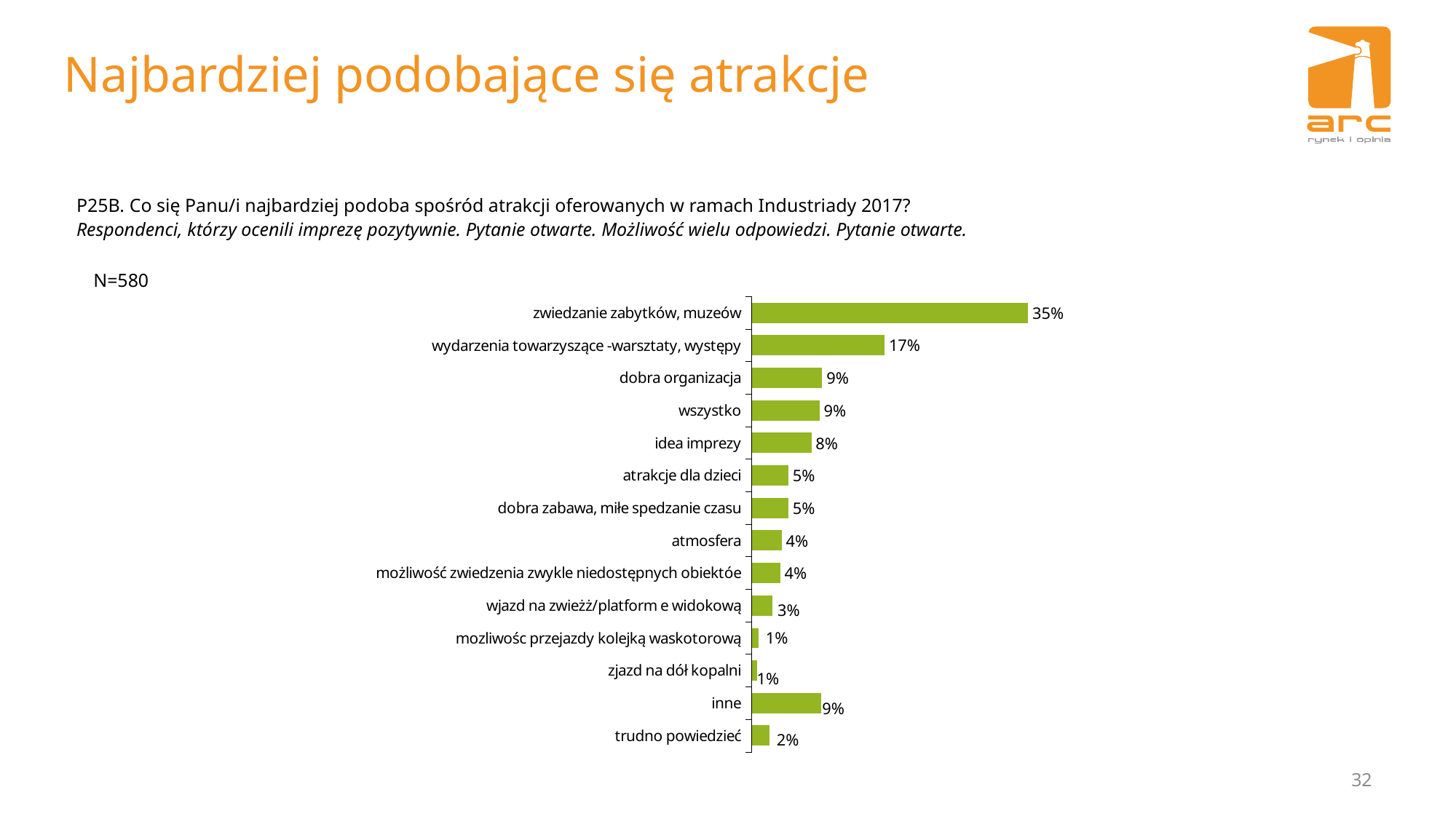
What is the difference between the values for "zwiedzanie zabytków, muzeów" and "wydarzenia towarzyszące -warsztaty, występy"? 18 percentage points What is the difference between the values for "dobra organizacja" and "atmosfera"? 5 percentage points What percentage is shown for "trudno powiedzieć"? 2% What type of chart is shown on the slide? Bar chart What is the value shown for "wydarzenia towarzyszące -warsztaty, występy"? 17% Which is larger: the value for "atrakcje dla dzieci" or the value for "wjazd na zwieżż/platform e widokową"? atrakcje dla dzieci How many categories are shown in the chart? 14 What value is shown for "idea imprezy"? 8% What percentage of respondents named "zwiedzanie zabytków, muzeów" as the attraction they liked most? 35% Which category has the highest value in the chart? zwiedzanie zabytków, muzeów What sample size (N) is stated on the slide? N=580 What value is shown for "inne"? 9%